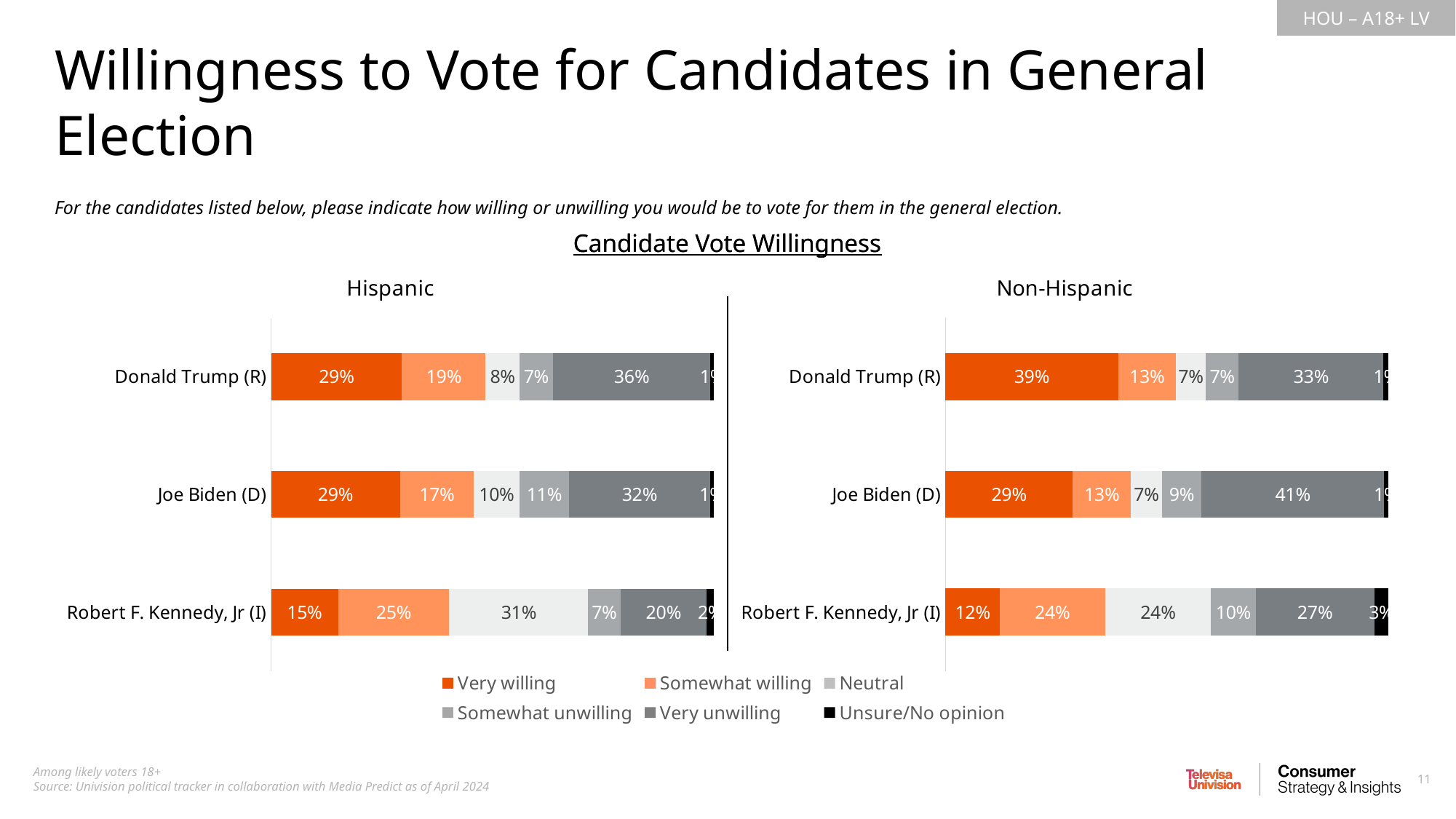
What colour represents the Very willing series in the legend? Dark orange In the Hispanic chart, which candidate has the lowest very willing percentage? Robert F. Kennedy, Jr (I) In the Hispanic chart, what percentage of respondents are very willing to vote for Donald Trump (R)? 29% In the Non-Hispanic chart, what percentage of respondents are very unwilling to vote for Joe Biden (D)? 41% In the Non-Hispanic chart, what percentage of respondents are somewhat willing to vote for Robert F. Kennedy, Jr (I)? 24% In the Hispanic chart, which is larger: the very unwilling percentage for Donald Trump (R) or for Joe Biden (D)? Donald Trump (R) In the Hispanic chart, what percentage of respondents are neutral on Robert F. Kennedy, Jr (I)? 31% In the Non-Hispanic chart, what is the difference between the very willing percentages for Donald Trump (R) and Joe Biden (D)? 10% In the Non-Hispanic chart, which candidate has the highest very willing percentage? Donald Trump (R) How many series does the legend list? 6 What type of chart is used for the Non-Hispanic data? Stacked bar chart How many candidates are shown in the Hispanic chart? 3